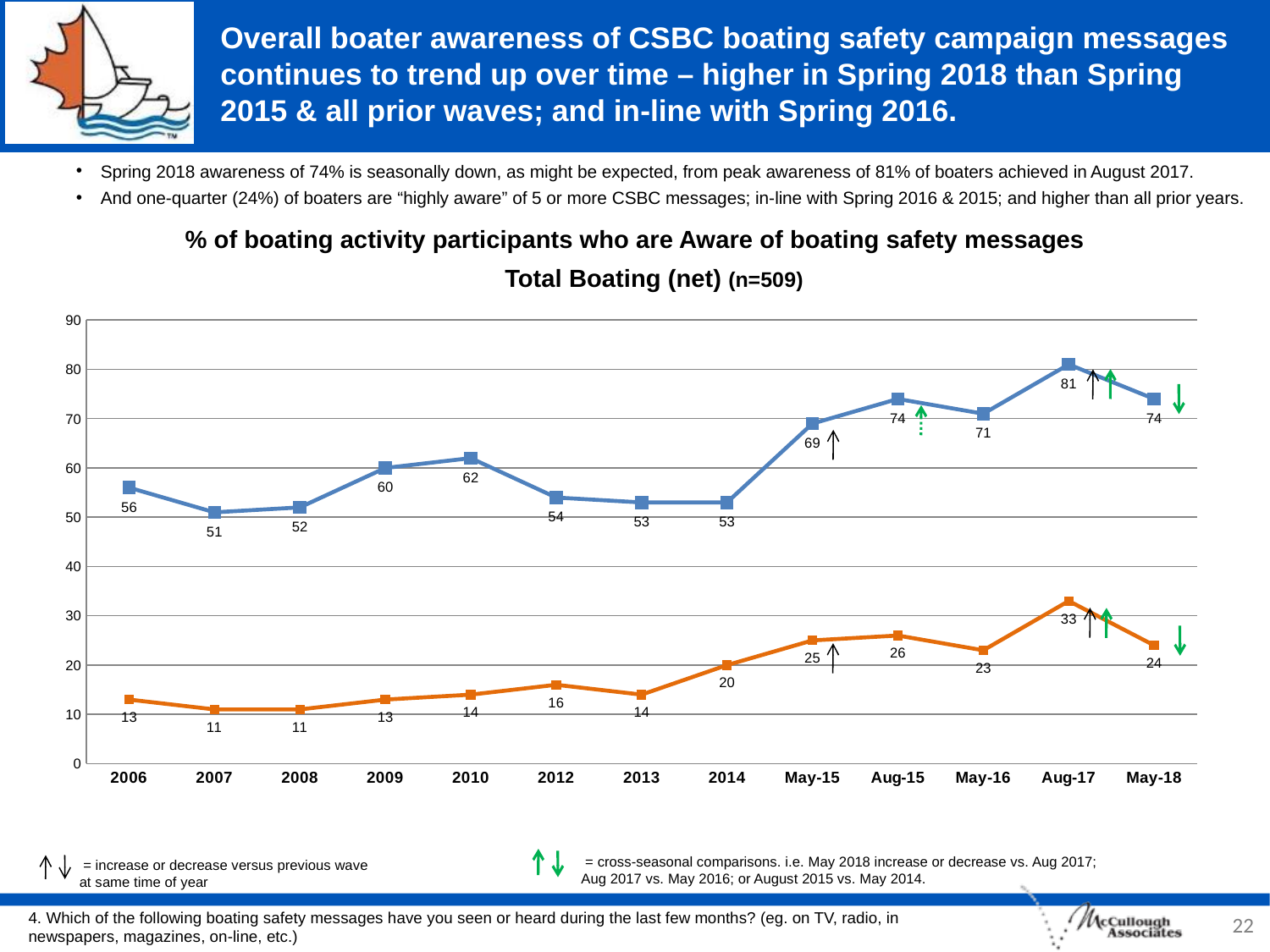
Which is larger on the lower (orange) line: the value for Aug-15 or the value for May-16? Aug-15 What is the difference between the upper (blue) line values for Aug-17 and May-18? 7 At which time point does the upper (blue) line reach its highest value? Aug-17 Does the upper (blue) line generally rise or fall from 2014 to Aug-17? rise What is the sample size (n) shown in the chart subtitle? n=509 How many time points are plotted along the x axis? 13 What is the value of the upper (blue) line for 2010? 62 At which time point does the upper (blue) line have its lowest value? 2007 What type of chart is shown on the slide? line chart What is the value of the lower (orange) line for May-18? 24 What is the value of the upper (blue) line for Aug-17? 81 How many lines are plotted on the chart? 2